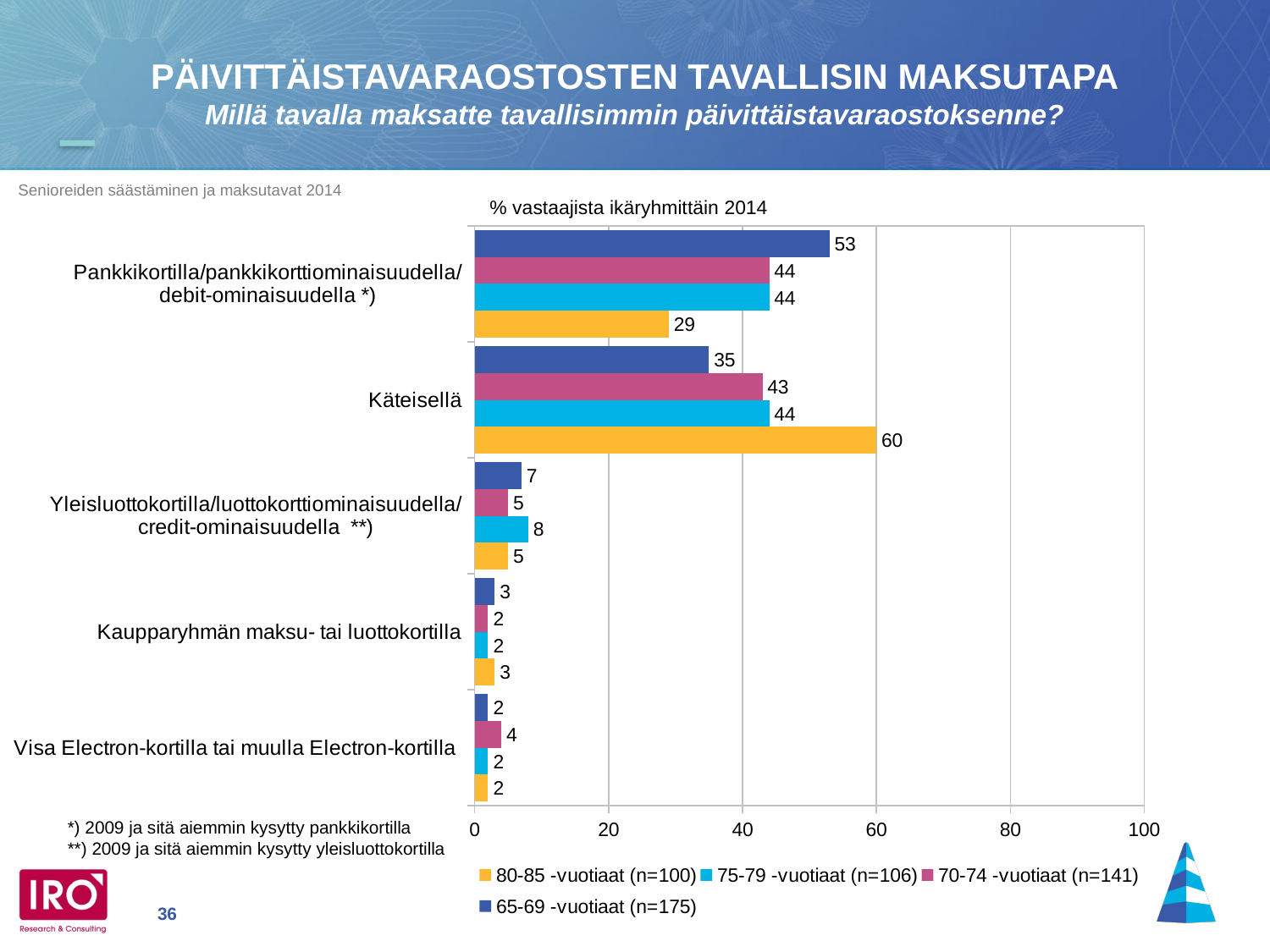
In the Pankkikortilla/pankkikorttiominaisuudella/debit-ominaisuudella category, which is larger: the value for 65-69 -vuotiaat or for 80-85 -vuotiaat? 65-69 -vuotiaat What is the value for 70-74 -vuotiaat in the Visa Electron-kortilla tai muulla Electron-kortilla category? 4 What is the value for 65-69 -vuotiaat in the Pankkikortilla/pankkikorttiominaisuudella/debit-ominaisuudella category? 53 What type of chart is shown on the slide? bar chart How many payment-method categories are shown on the chart? 5 Which age group has the highest value in the Käteisellä category? 80-85 -vuotiaat What is the difference between the 80-85 -vuotiaat value and the 65-69 -vuotiaat value in the Käteisellä category? 25 What is the value for 75-79 -vuotiaat in the Yleisluottokortilla/luottokorttiominaisuudella/credit-ominaisuudella category? 8 Which age group has the lowest value in the Pankkikortilla/pankkikorttiominaisuudella/debit-ominaisuudella category? 80-85 -vuotiaat What is the value for 80-85 -vuotiaat in the Käteisellä category? 60 How many series does the legend list? 4 What is the title printed above the chart's plot area? % vastaajista ikäryhmittäin 2014